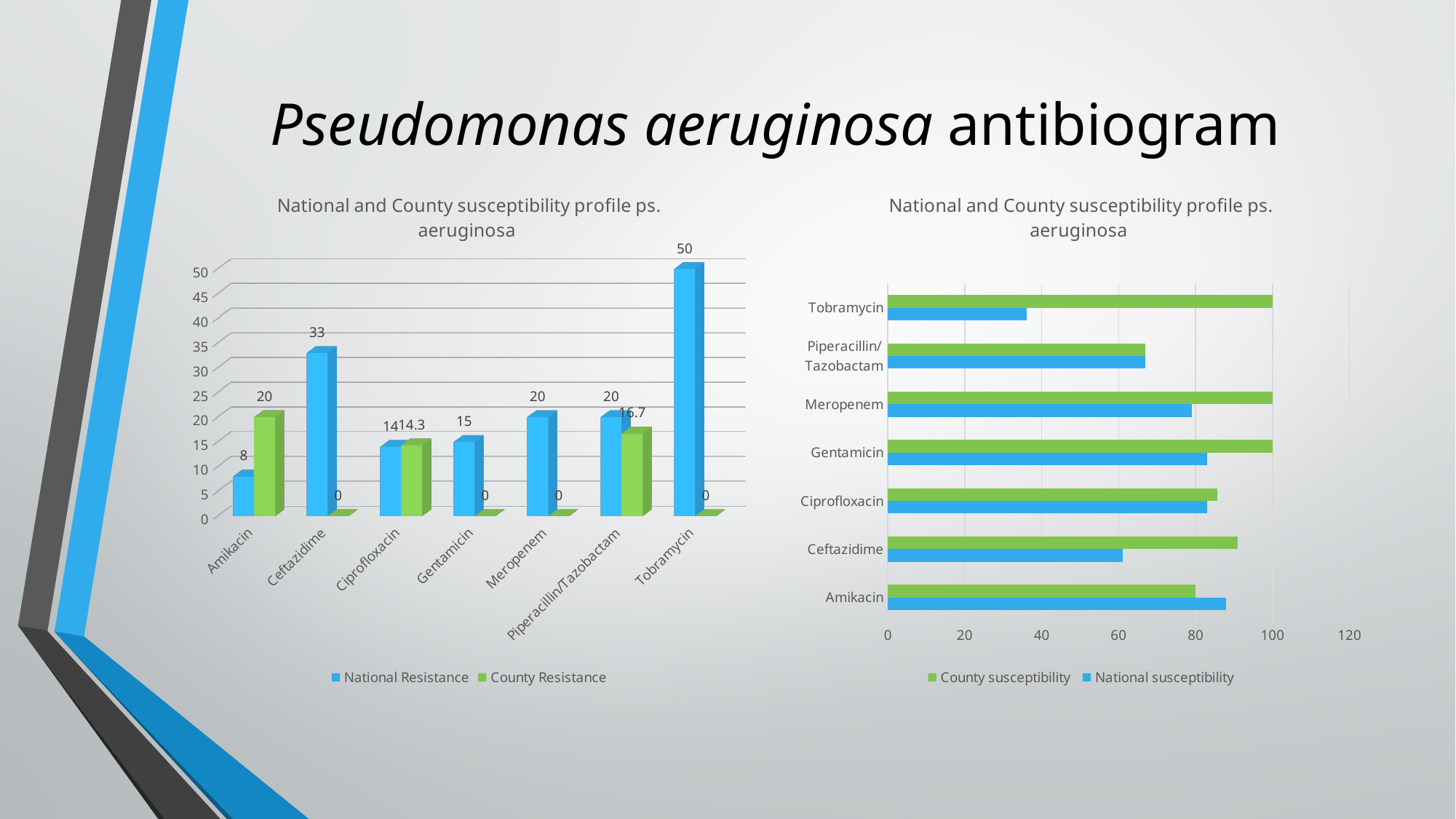
On the left chart, which antibiotic has the highest National Resistance value? Tobramycin On the left chart, what is the County Resistance value for Piperacillin/Tazobactam? 16.7 On the right chart, is the County susceptibility value for Ceftazidime greater or less than 80? greater On the right chart, is the National susceptibility value for Tobramycin greater or less than 40? less On the left chart, what is the County Resistance value for Amikacin? 20 On the left chart, which is larger for Amikacin: National Resistance or County Resistance? County Resistance On the right chart, which is larger for Tobramycin: County susceptibility or National susceptibility? County susceptibility On the left chart, which antibiotic has the lowest National Resistance value? Amikacin On the left chart, what is the National Resistance value for Ceftazidime? 33 How many series does the legend of the right chart list? 2 On the left chart, what is the difference between the National Resistance values for Tobramycin and Ceftazidime? 17 On the left chart, how many antibiotics are shown on the x axis? 7